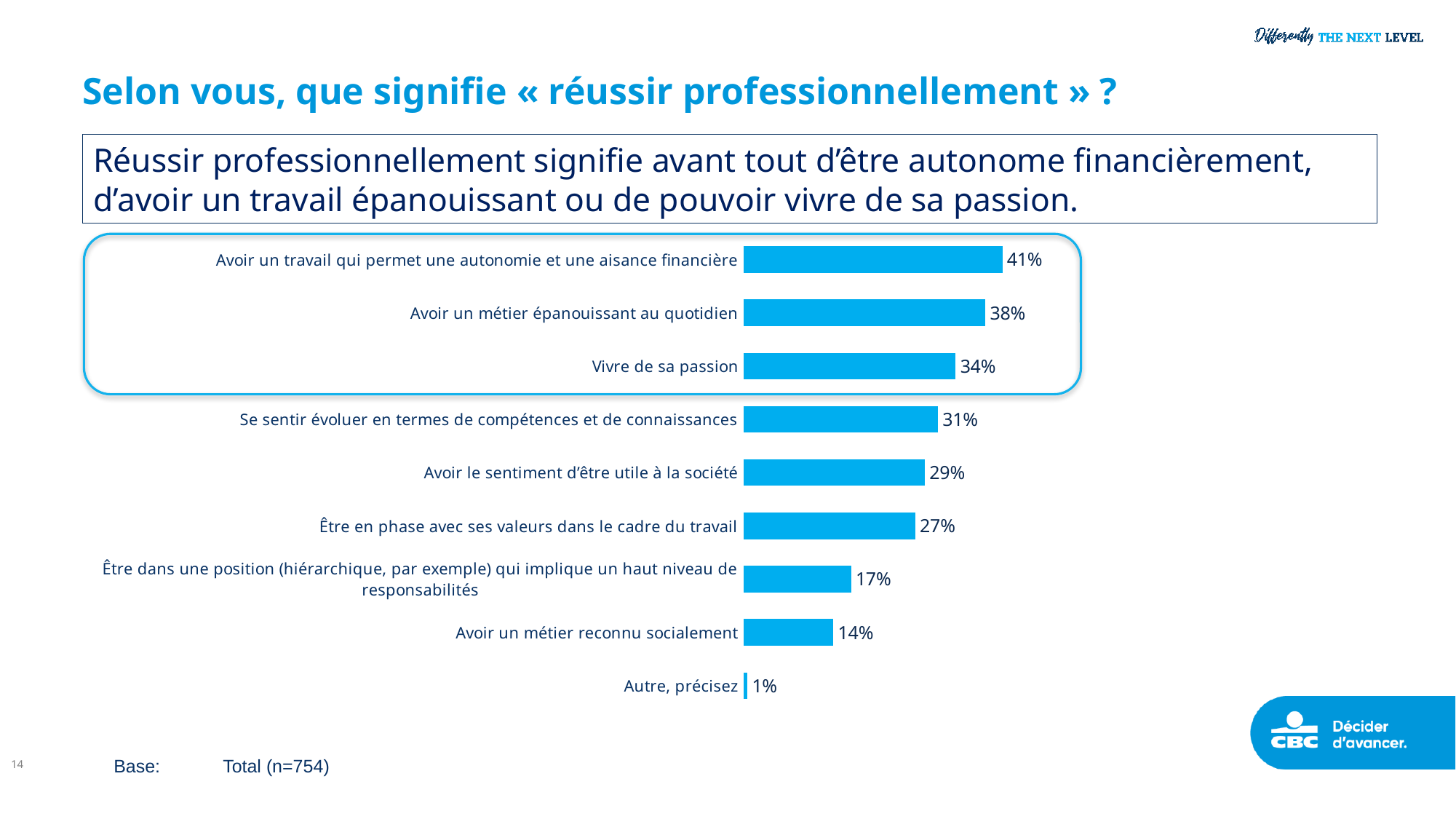
What is the difference between "Avoir un travail qui permet une autonomie et une aisance financière" and "Avoir un métier épanouissant au quotidien"? 3% What is the value for "Avoir un métier reconnu socialement"? 14% Which category has the highest value? Avoir un travail qui permet une autonomie et une aisance financière What is the value for the category about being in a position with a high level of responsibilities? 17% What is the value for "Se sentir évoluer en termes de compétences et de connaissances"? 31% How many categories are enclosed in the highlighted rounded box at the top of the chart? 3 What percentage of respondents chose "Vivre de sa passion"? 34% How many categories are shown in the chart? 9 What kind of chart is shown on the slide? Bar chart Which is larger: "Avoir le sentiment d'être utile à la société" or "Être en phase avec ses valeurs dans le cadre du travail"? Avoir le sentiment d'être utile à la société What is the difference between "Être en phase avec ses valeurs dans le cadre du travail" and "Avoir un métier reconnu socialement"? 13% Which category has the lowest value? Autre, précisez